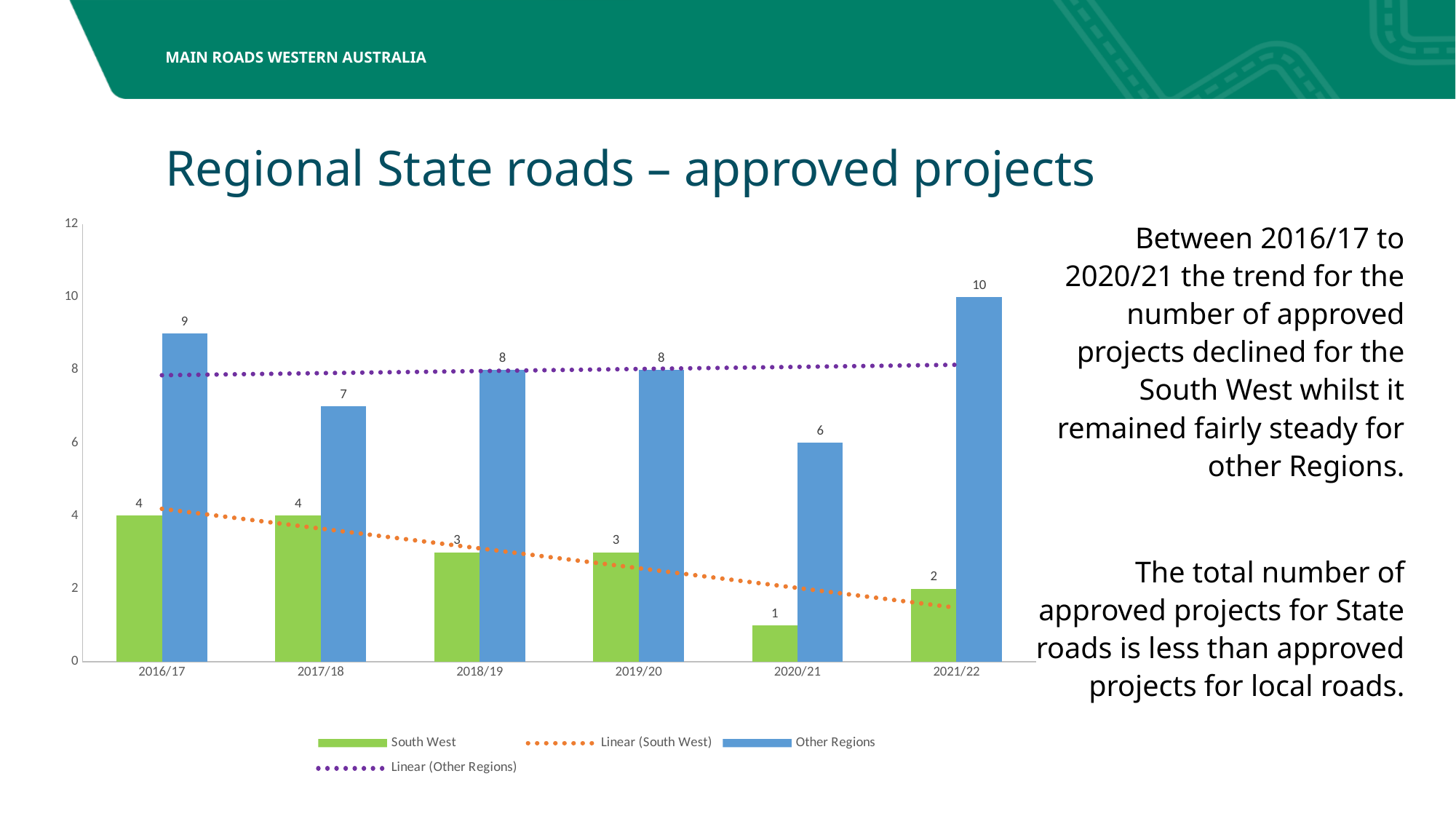
Which year has the highest value for Other Regions? 2021/22 Do the South West values rise or fall from 2016/17 to 2020/21? Fall Which year has the lowest value for South West? 2020/21 What is the value for South West in 2016/17? 4 What is the value for Other Regions in 2021/22? 10 Which is larger in 2017/18, South West or Other Regions? Other Regions What is the difference between Other Regions and South West in 2019/20? 5 What colour are the Other Regions bars? Blue How many years are shown on the x axis? 6 How many entries does the legend list? 4 What kind of chart is shown on the slide? Bar chart What is the value for South West in 2020/21? 1